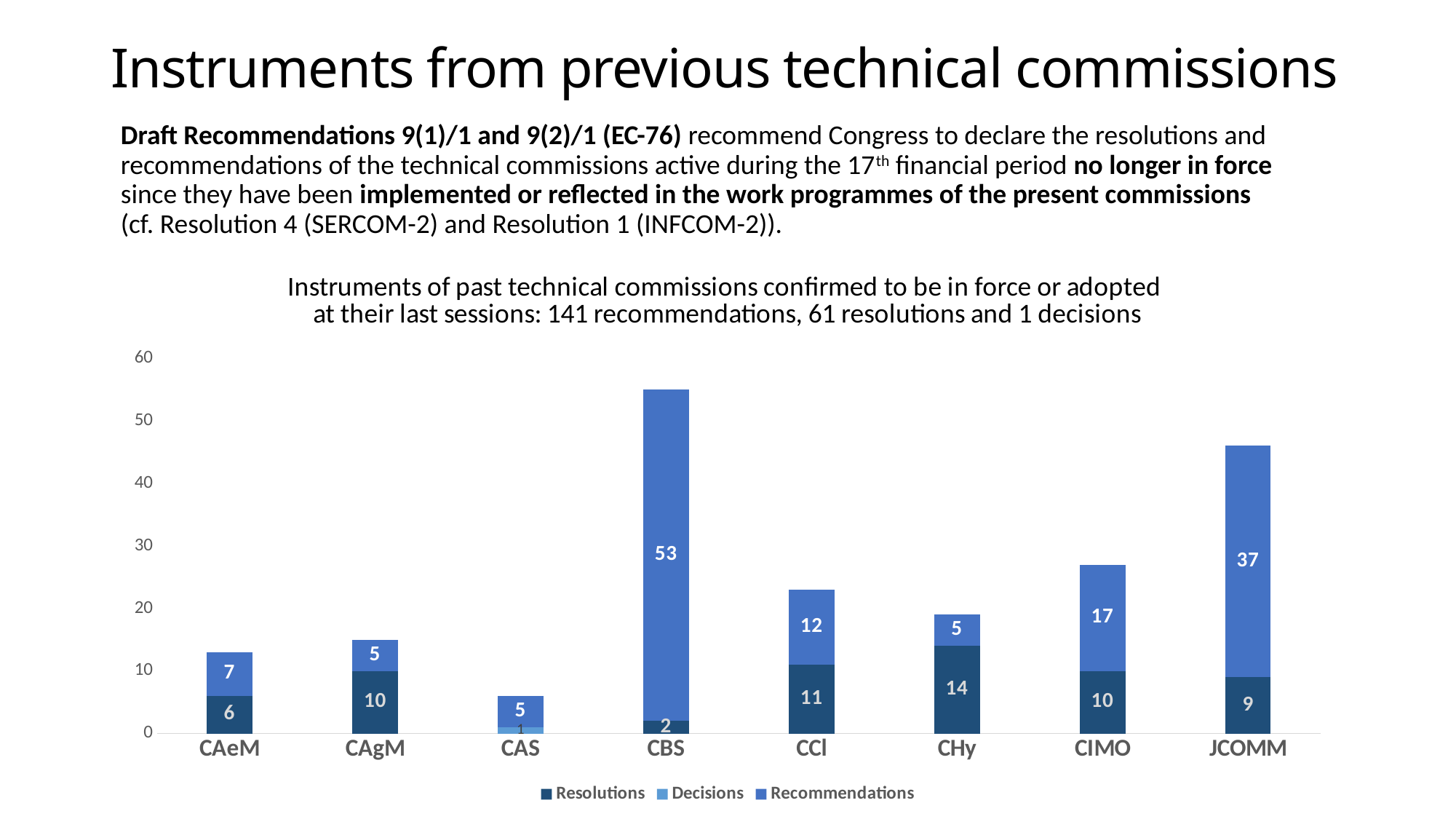
How many resolutions are shown for CHy? 14 What type of chart is shown on the slide? Stacked bar chart Which commission has the highest number of recommendations? CBS How many recommendations are shown for CIMO? 17 Which commission has the lowest number of resolutions among those with a Resolutions label? CBS What is the total height of the stacked bar for JCOMM? 46 What is the total height of the stacked bar for CCl? 23 How many series does the legend list? 3 How many technical commissions (categories) are shown on the x axis? 8 How many recommendations are shown for CBS? 53 Which is larger: the resolutions for CAgM or the resolutions for CAeM? CAgM What is the difference between the recommendations for JCOMM and for CIMO? 20